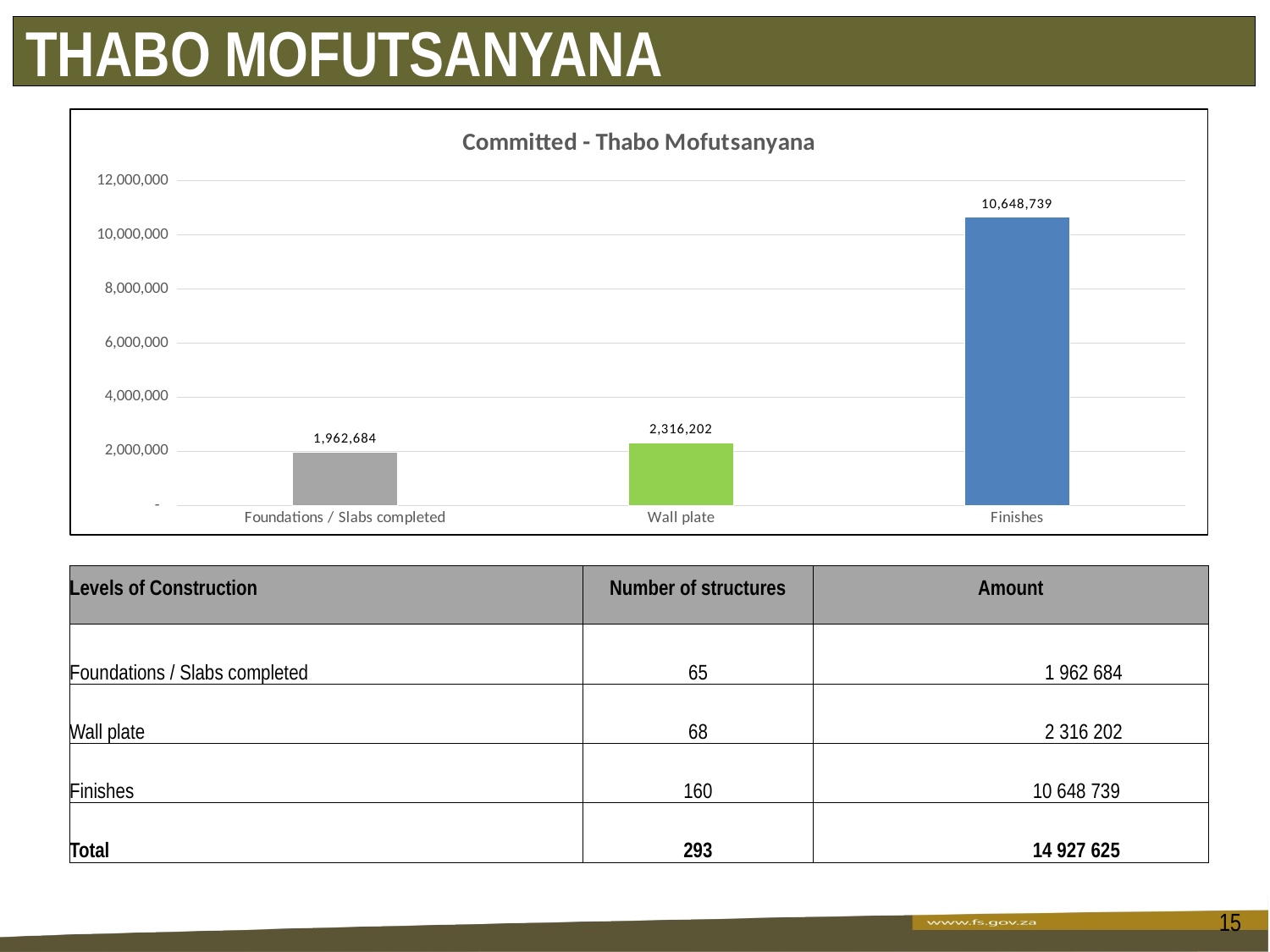
What is the value for Finishes in the chart? 10,648,739 What is the difference between the values for Finishes and Wall plate? 8,332,537 What kind of chart is shown on the slide? Bar chart What is the difference between the values for Wall plate and Foundations / Slabs completed? 353,518 Is the value for Finishes greater or less than 10,000,000? greater What is the value for Foundations / Slabs completed in the chart? 1,962,684 Which category has the lowest value in the chart? Foundations / Slabs completed Which is larger, the value for Wall plate or the value for Foundations / Slabs completed? Wall plate What is the title of the chart? Committed - Thabo Mofutsanyana What is the value for Wall plate in the chart? 2,316,202 Which category has the highest value in the chart? Finishes How many categories are shown in the chart? 3